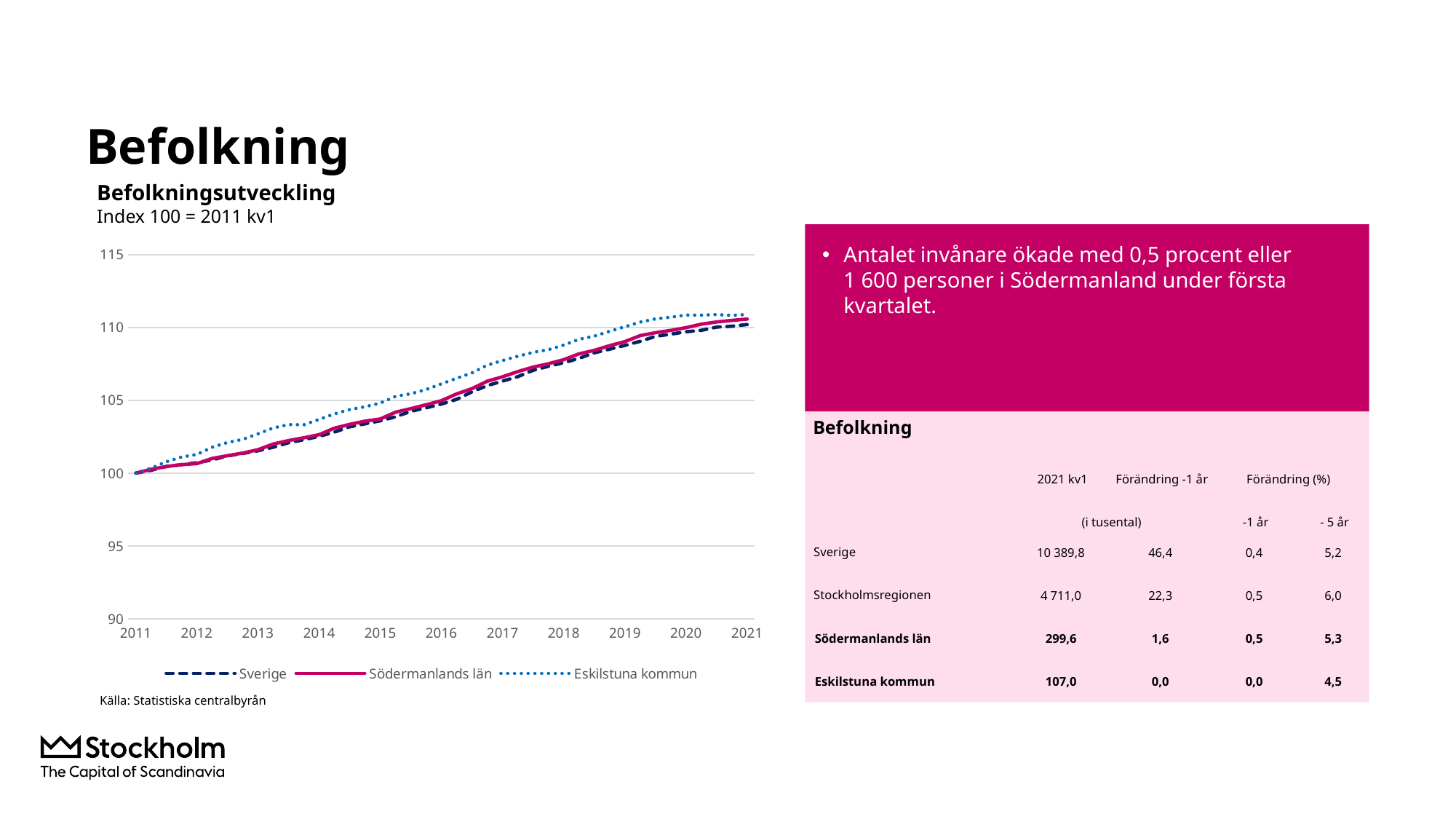
What is the title of the chart? Befolkningsutveckling Do the index values rise or fall from 2011 to 2021? rise Which series has the highest index value in 2021? Eskilstuna kommun What kind of chart is shown on the slide? line chart In 2019, which is higher: the index for Eskilstuna kommun or for Sverige? Eskilstuna kommun Is the index value for Eskilstuna kommun in 2013 greater or less than 105? less How many year labels are shown on the x axis? 11 Is the index value for Sverige in 2015 greater or less than 105? less Is the index value for Eskilstuna kommun in 2021 greater or less than 110? greater Which series are listed in the chart legend? Sverige, Södermanlands län, Eskilstuna kommun How many series does the chart legend list? 3 What is the index value of all three series at the start of 2011? 100